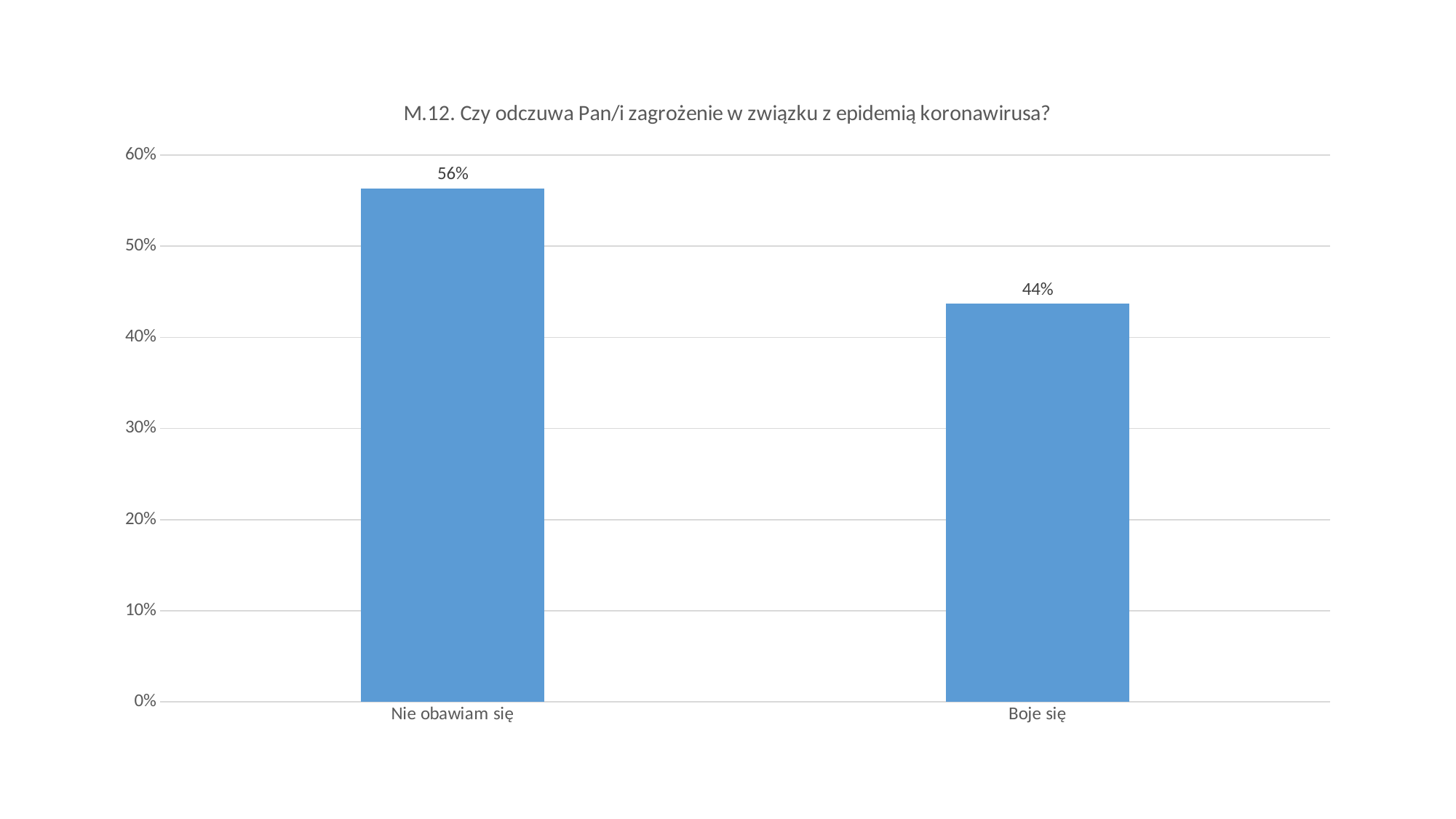
What kind of chart is shown on the slide? Bar chart Is the value for "Nie obawiam się" greater or less than 50%? greater What is the value for "Nie obawiam się"? 56% Which category has the highest value? Nie obawiam się How many categories are shown on the chart? 2 What is the value for "Boje się"? 44% Which category has the lowest value? Boje się What is the highest value shown on the vertical axis? 60% What is the difference between the values for "Nie obawiam się" and "Boje się"? 12% Which is larger, the value for "Nie obawiam się" or the value for "Boje się"? Nie obawiam się Is the value for "Boje się" greater or less than 50%? less What is the title of the chart? M.12. Czy odczuwa Pan/i zagrożenie w związku z epidemią koronawirusa?